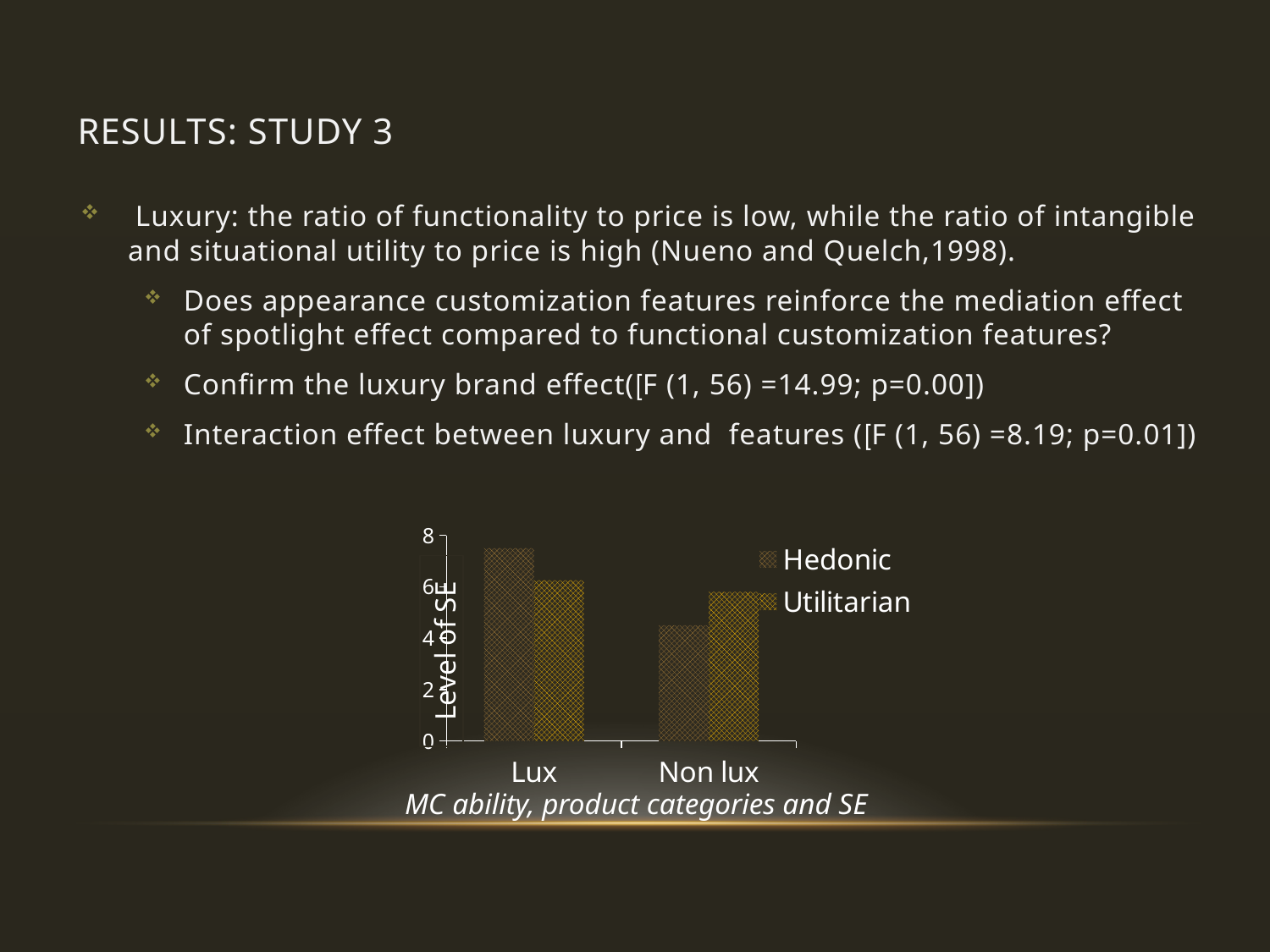
Is the Hedonic value for Non lux greater or less than 6? less How many categories are shown on the x axis of the chart? 2 Is the Utilitarian value for Lux greater or less than 4? greater What is the label of the chart's vertical axis? Level of SE Which bar is the shortest in the chart? Hedonic for Non lux Which bar is the tallest in the chart? Hedonic for Lux For the Non lux category, which is larger, the Hedonic bar or the Utilitarian bar? Utilitarian Is the Hedonic value for Lux greater or less than 6? greater What kind of chart is shown on the slide? bar chart For the Lux category, which is larger, the Hedonic bar or the Utilitarian bar? Hedonic Which series are listed in the chart's legend? Hedonic and Utilitarian How many series does the chart's legend list? 2